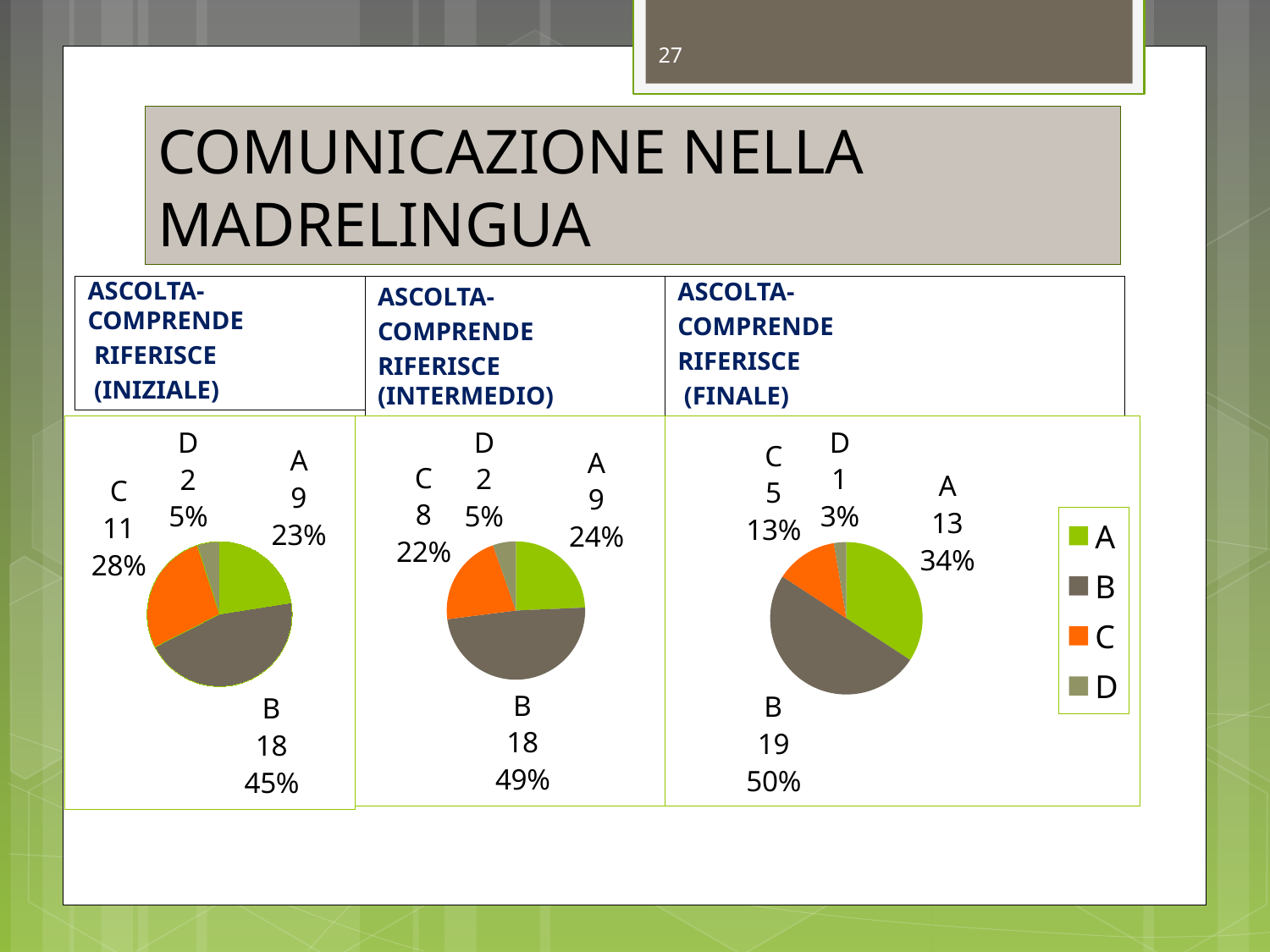
How many entries does the legend on the right of the slide list? 4 In the INTERMEDIO pie chart, what is the value for category C? 8 In the FINALE pie chart, what is the value for category A? 13 In the INTERMEDIO pie chart, what share of the pie does category B represent? 49% In the FINALE pie chart, which category has the smallest slice? D What type of chart is used for the FINALE data? Pie chart In the FINALE pie chart, which category has the largest slice? B In the INIZIALE pie chart, what share of the pie does category C represent? 28% How many categories does the INTERMEDIO pie chart show? 4 In the INIZIALE pie chart, which is larger, the value for C or the value for A? C In the INIZIALE pie chart, what is the value for category B? 18 In the FINALE pie chart, what is the difference between the values for B and A? 6